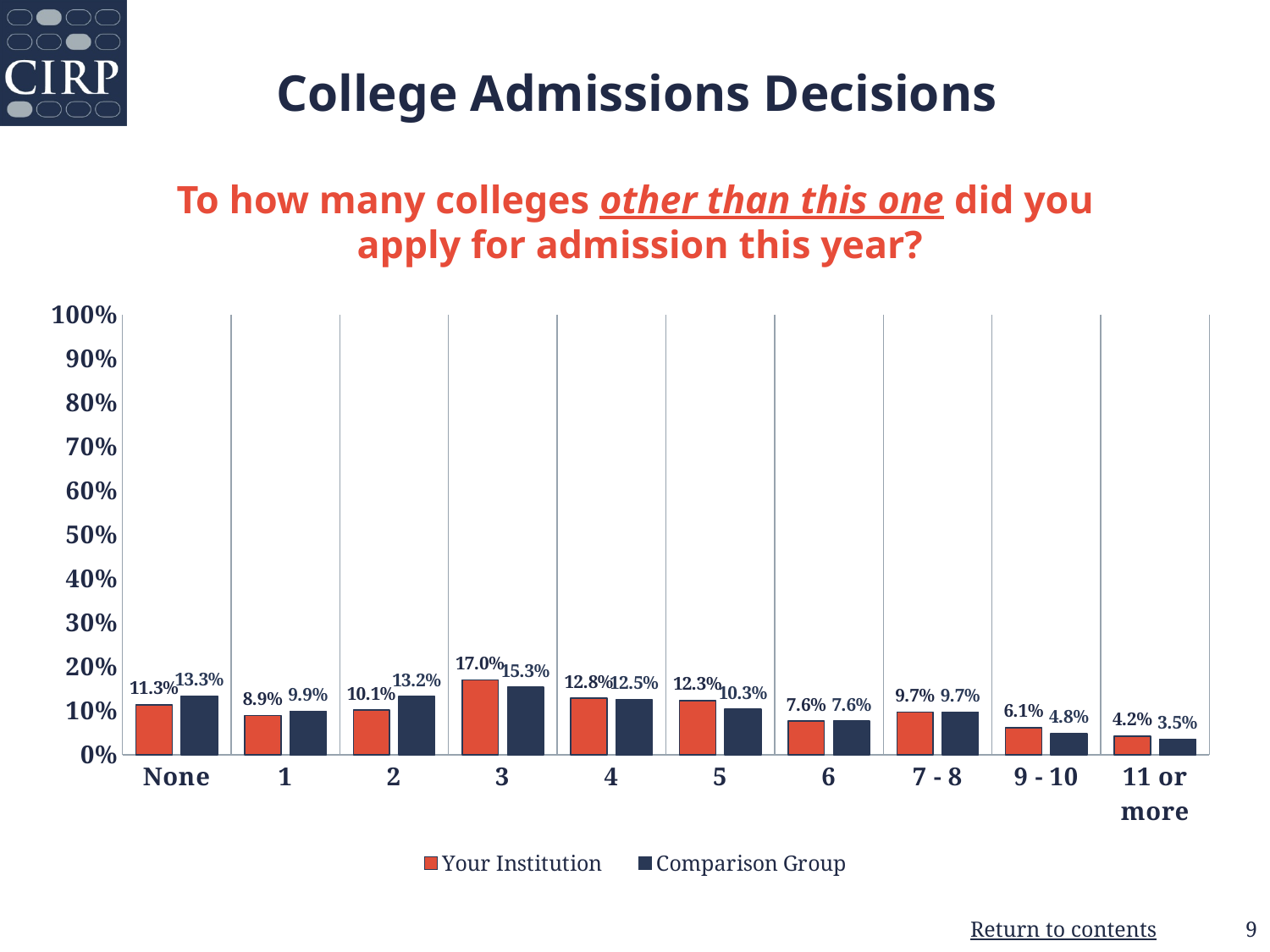
Is the Your Institution value for category 3 greater or less than 20%? less Which category has the highest value for the Comparison Group? 3 What percentage of Your Institution respondents applied to 3 other colleges? 17.0% Which category has the lowest value for Your Institution? 11 or more How many series does the legend list? 2 What kind of chart is shown on the slide? bar chart What is the Your Institution value for '11 or more'? 4.2% What is the Comparison Group value for the 'None' category? 13.3% For category 5, which series has the larger value, Your Institution or Comparison Group? Your Institution What are the two series named in the legend? Your Institution and Comparison Group What is the difference between Your Institution and the Comparison Group for category 2? 3.1% How many categories are shown on the x axis? 10